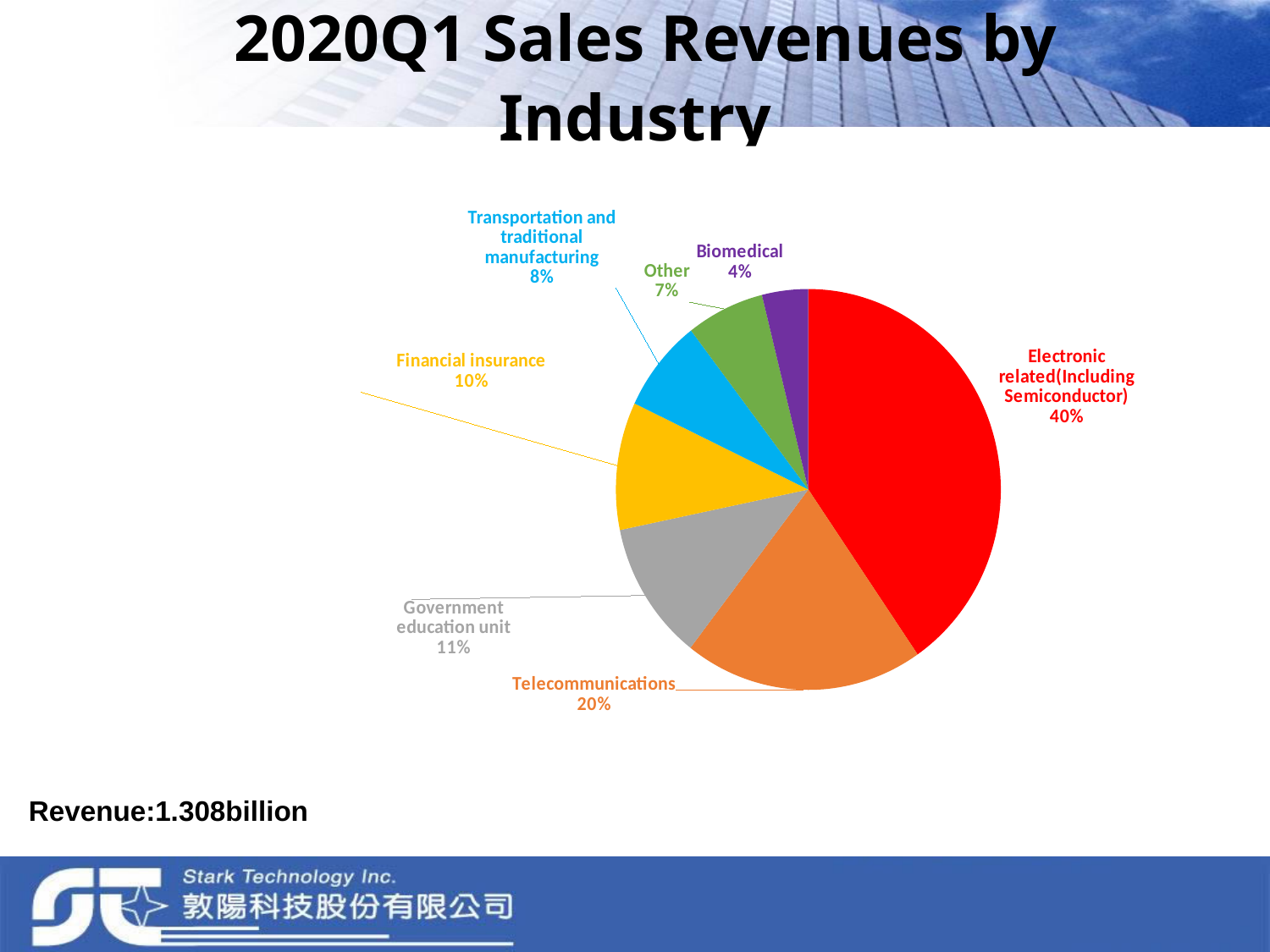
What share of 2020Q1 sales revenues comes from Government education unit? 11% How many industry slices does the pie chart show? 7 Which industry has the smallest share of 2020Q1 sales revenues? Biomedical What share of 2020Q1 sales revenues comes from Telecommunications? 20% Which has a larger share of 2020Q1 sales revenues, Financial insurance or Other? Financial insurance How many percentage points larger is the Electronic related share than the Telecommunications share? 20 What share of 2020Q1 sales revenues comes from Electronic related (Including Semiconductor)? 40% What share of 2020Q1 sales revenues comes from Transportation and traditional manufacturing? 8% What share of 2020Q1 sales revenues comes from Financial insurance? 10% Which industry has the largest share of 2020Q1 sales revenues? Electronic related(Including Semiconductor) What share of 2020Q1 sales revenues comes from Biomedical? 4% What type of chart is shown on the slide? Pie chart